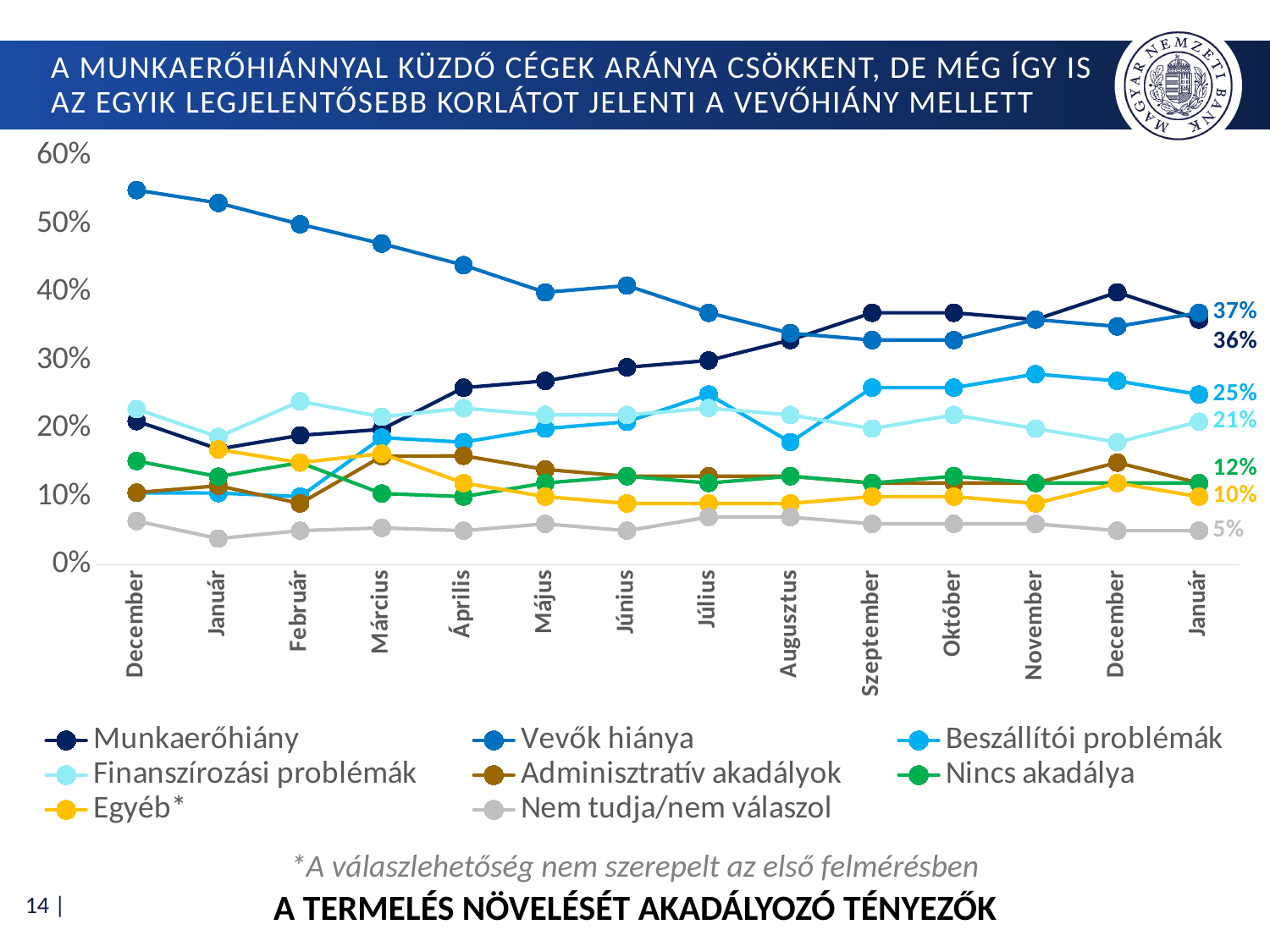
What is the value for Beszállítói problémák at the final January point? 25% What is the difference between the final January values of Beszállítói problémák and Finanszírozási problémák? 4 percentage points What is the value for Nem tudja/nem válaszol at the final January point? 5% What is the value for Munkaerőhiány at the final January point? 36% Which series has the lowest value at the final January point? Nem tudja/nem válaszol What is the value for Vevők hiánya at the final January point? 37% Does the Vevők hiánya series rise or fall from the first December to the final January? fall Is the value for Vevők hiánya in the first December greater or less than 50%? greater How many months are shown along the x axis? 14 How many series does the legend list? 8 Does the Munkaerőhiány series rise or fall from the first December to the final January? rise What kind of chart is shown on the slide? line chart